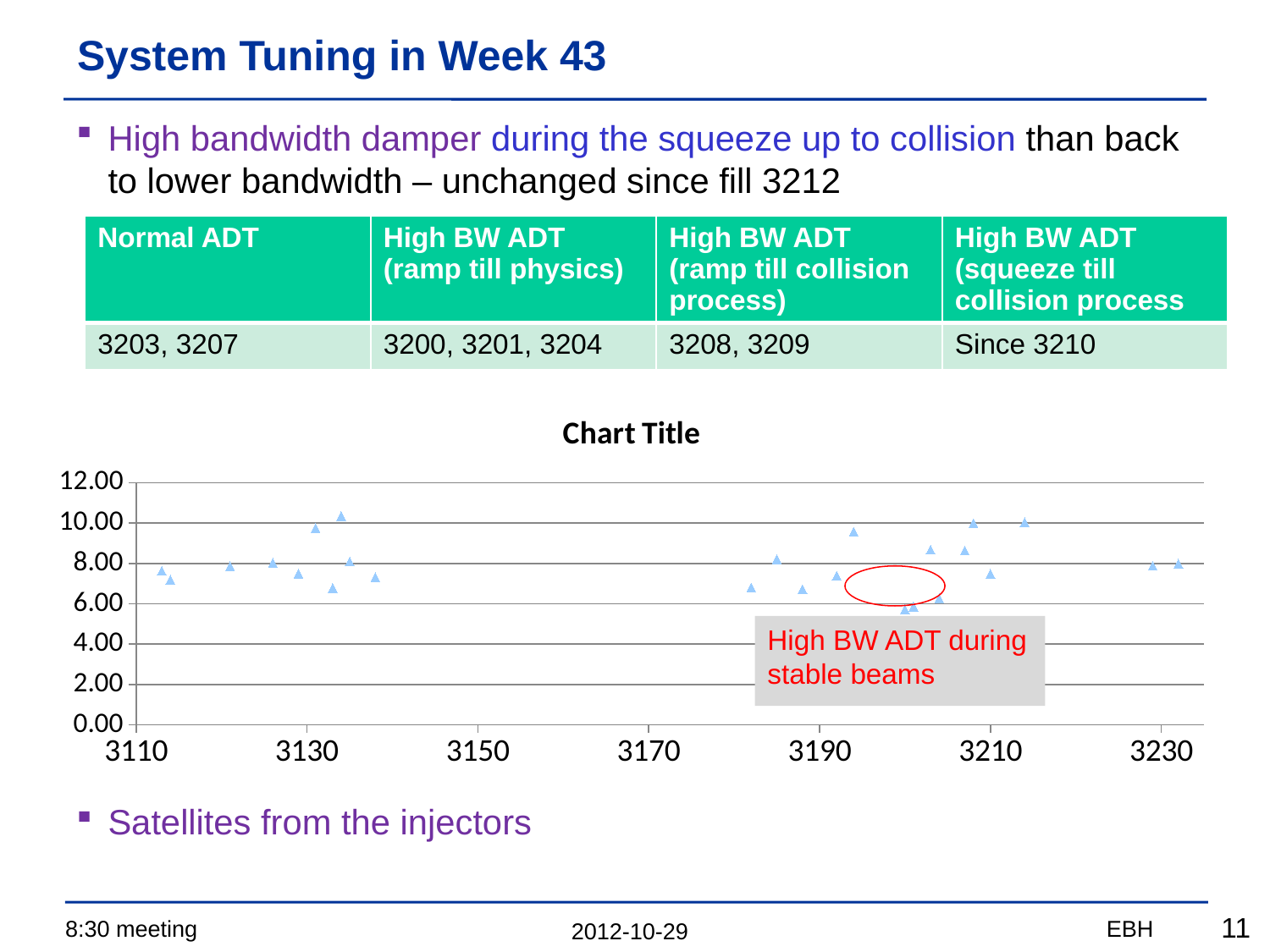
What is the title shown above the chart? Chart Title Are all the plotted points in the chart above the 4.00 gridline? yes Is the plotted point near x = 3113 greater or less than 6.00? greater What is the highest value labelled on the chart's vertical axis? 12.00 What text appears in the annotation box inside the chart? High BW ADT during stable beams What is the lowest value labelled on the chart's horizontal axis? 3110 Is the lowest plotted point in the chart (near x = 3201) greater or less than 6.00? less What kind of chart is shown on the slide? scatter chart What is the highest value labelled on the chart's horizontal axis? 3230 How many tick labels are shown on the chart's horizontal axis? 7